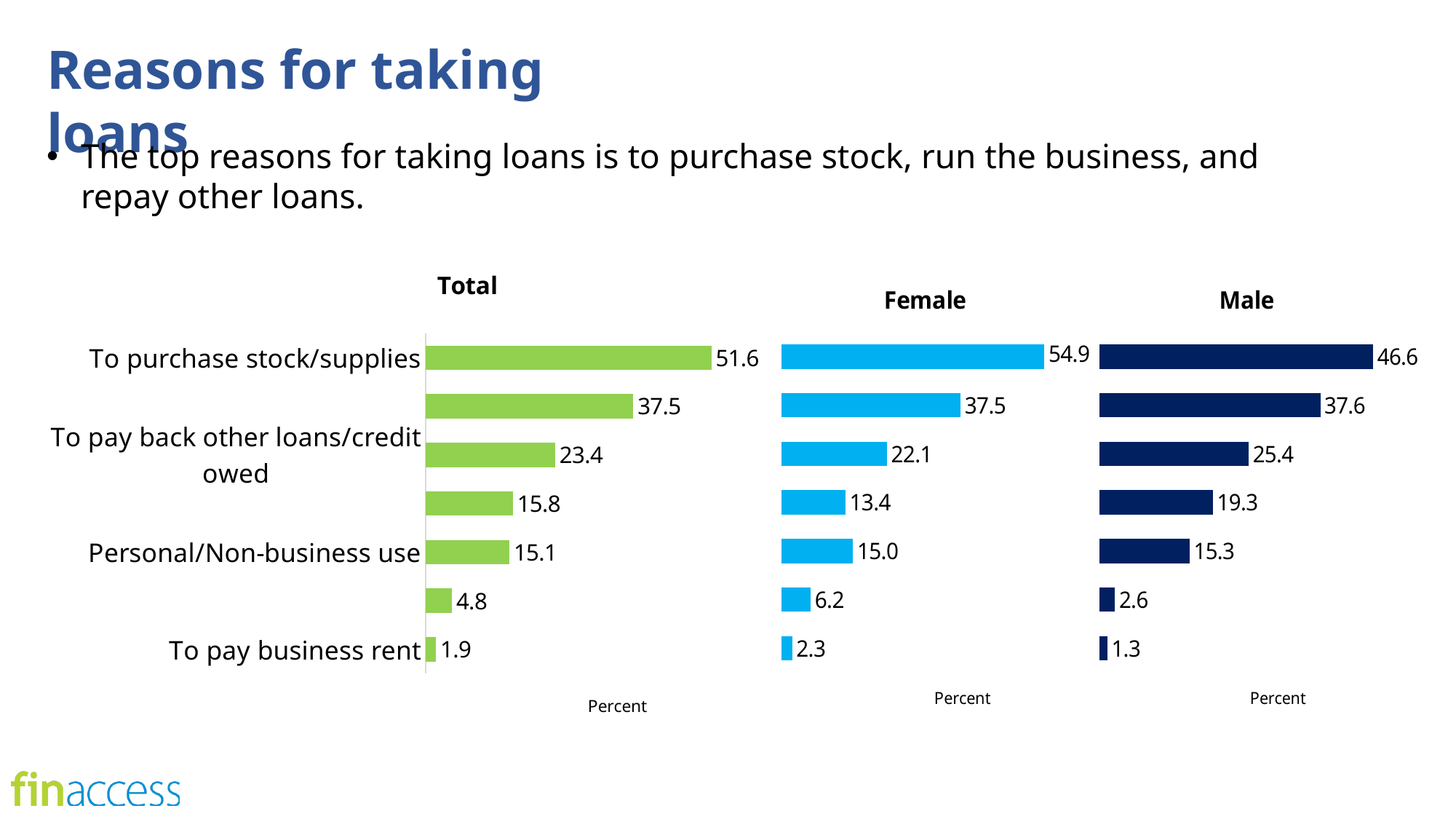
In the Total chart, which is larger: To pay back other loans/credit owed or Personal/Non-business use? To pay back other loans/credit owed In the Male chart, what is the value for Personal/Non-business use? 15.3 In the Male chart, what is the value for To pay business rent? 1.3 In the Total chart, what is the difference between To purchase stock/supplies and To pay business rent? 49.7 In the Male chart, which category has the lowest value? To pay business rent For To purchase stock/supplies, which chart shows the larger value, Female or Male? Female What is the difference between the Female and Male values for To purchase stock/supplies? 8.3 What type of chart is used on this slide? Bar chart In the Total chart, which category has the highest value? To purchase stock/supplies How many bars are in the Total chart? 7 In the Total chart, what is the value for To purchase stock/supplies? 51.6 In the Female chart, what is the value for To pay back other loans/credit owed? 22.1